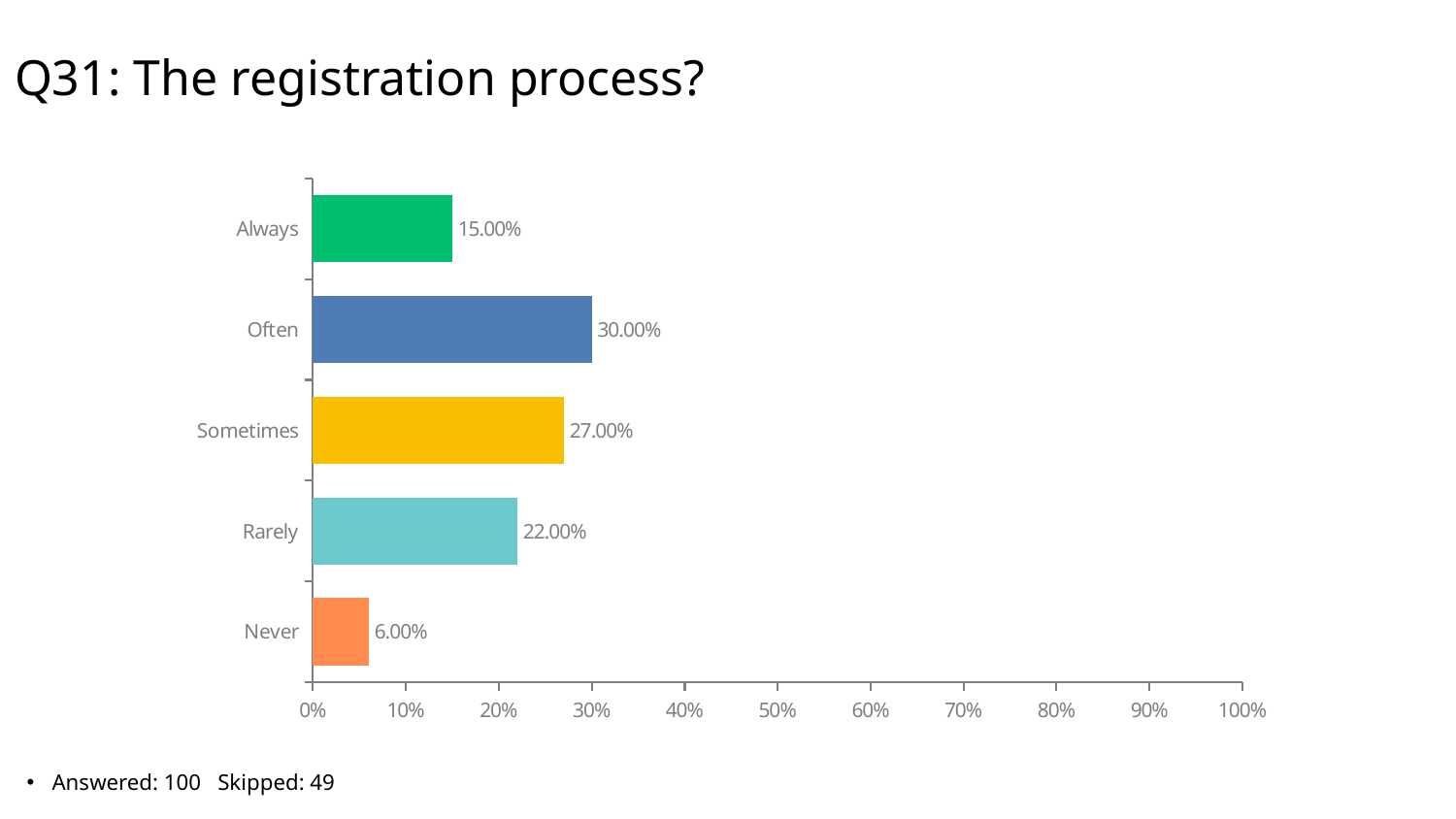
How many categories are shown in the chart? 5 Which is larger, the value for Rarely or the value for Always? Rarely What kind of chart is shown on the slide? Bar chart What is the value for Never? 6.00% What is the value for Often? 30.00% Which category has the highest value? Often What is the value for Rarely? 22.00% Is the value for Sometimes greater or less than 20%? greater Which category has the lowest value? Never What is the value for Sometimes? 27.00% What is the value for Always? 15.00% What is the difference between the values for Often and Sometimes? 3.00%